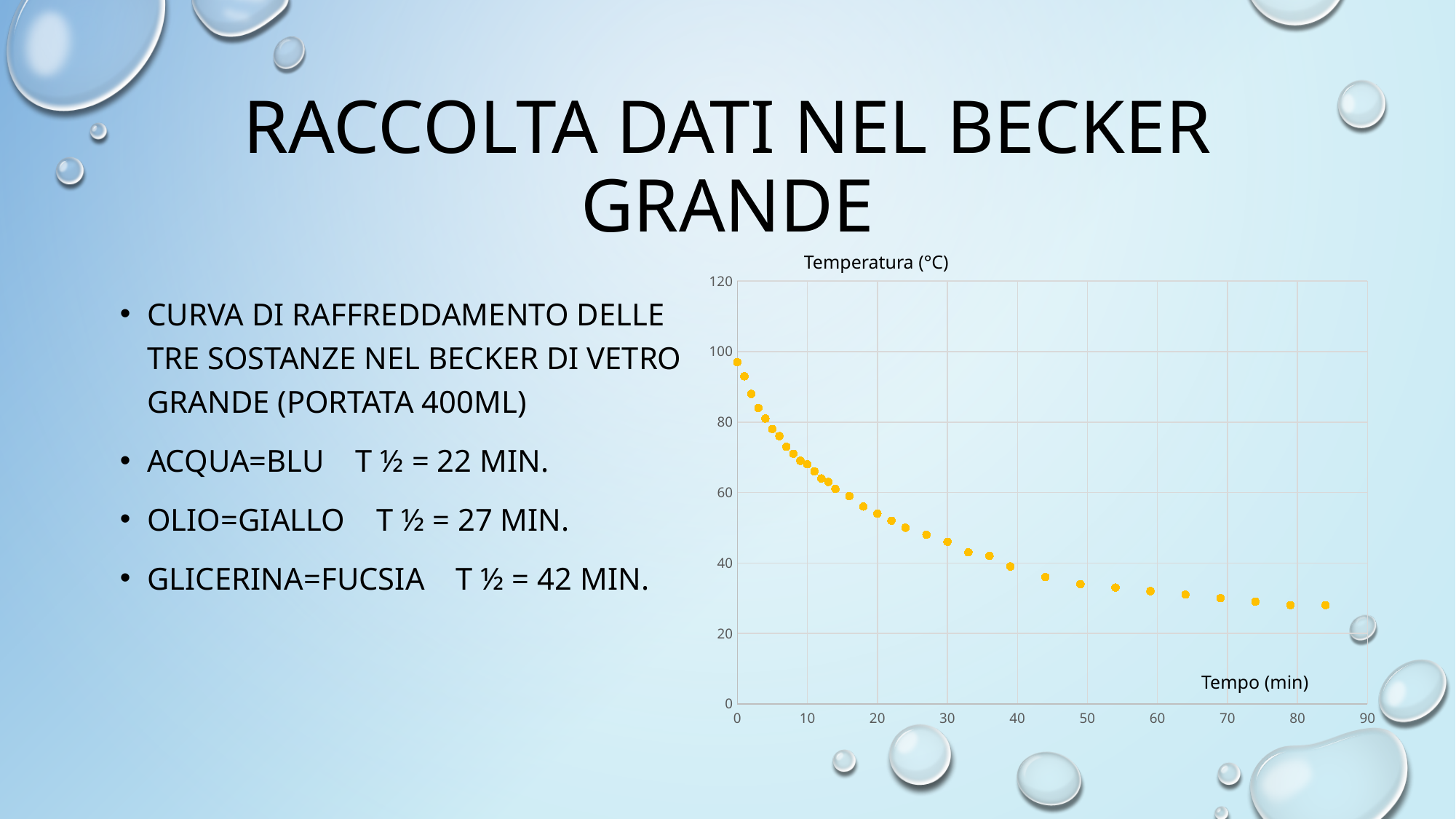
Do the plotted temperature values rise or fall as time increases along the x axis? fall Which is higher, the temperature at 10 minutes or the temperature at 50 minutes? 10 minutes What is the title of the vertical axis of the chart? Temperatura (°C) What is the title of the horizontal axis of the chart? Tempo (min) Is the temperature at 80 minutes greater or less than 40? less What kind of chart is shown on the slide? scatter chart Is the temperature at 20 minutes greater or less than 80? less Is the temperature at 0 minutes greater or less than 80? greater